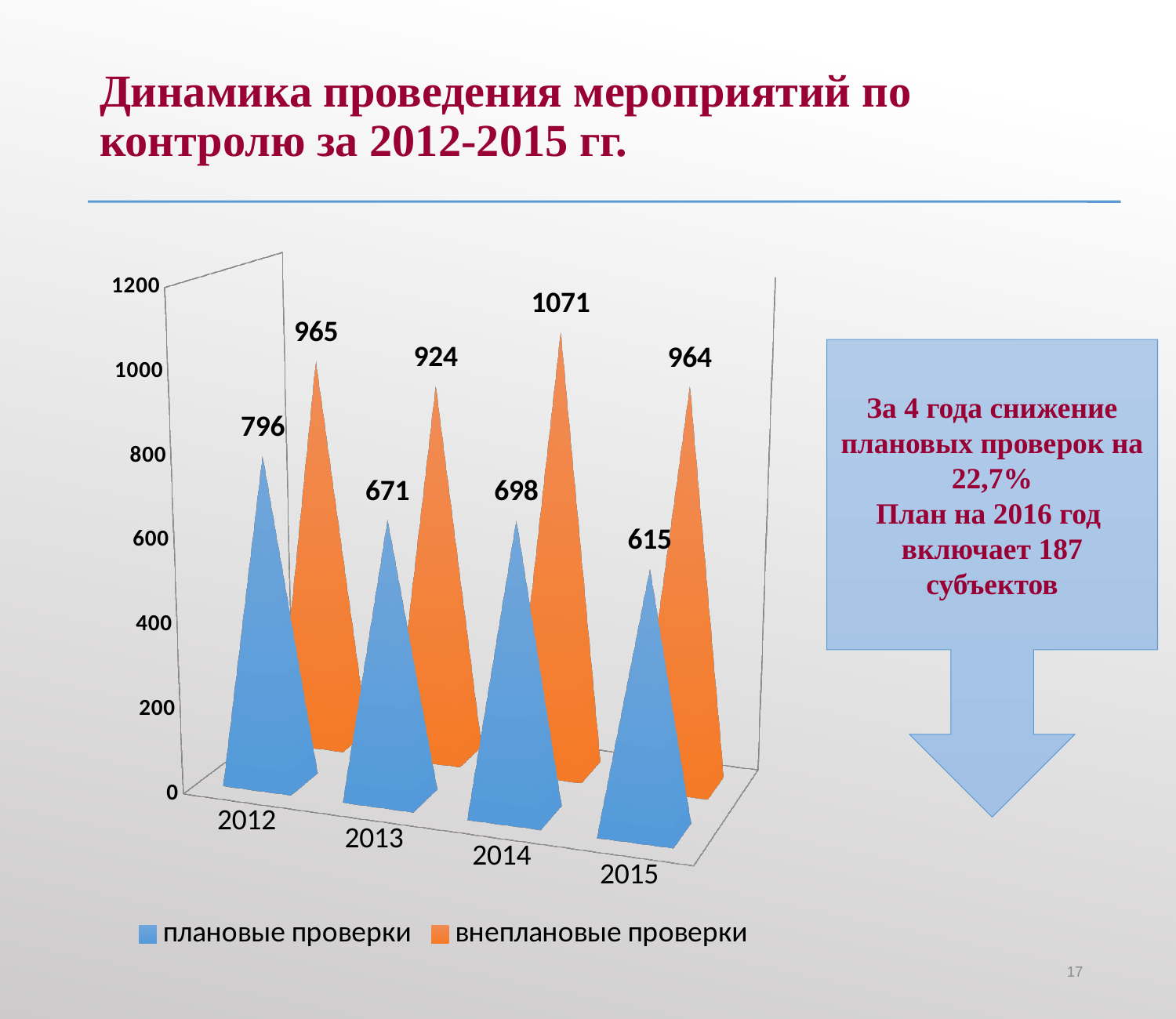
What is the value for внеплановые проверки in 2014? 1071 Do the values for плановые проверки rise or fall from 2012 to 2015 overall? fall How many series does the legend list? 2 Which colour represents внеплановые проверки in the legend? orange What is the value for плановые проверки in 2015? 615 In which year is the value for плановые проверки lowest? 2015 In which year is the value for внеплановые проверки highest? 2014 How many years are shown on the x axis? 4 What is the value for плановые проверки in 2012? 796 What kind of chart is shown on the slide? bar chart Which is larger in 2015: плановые проверки or внеплановые проверки? внеплановые проверки What is the difference between внеплановые проверки and плановые проверки in 2013? 253